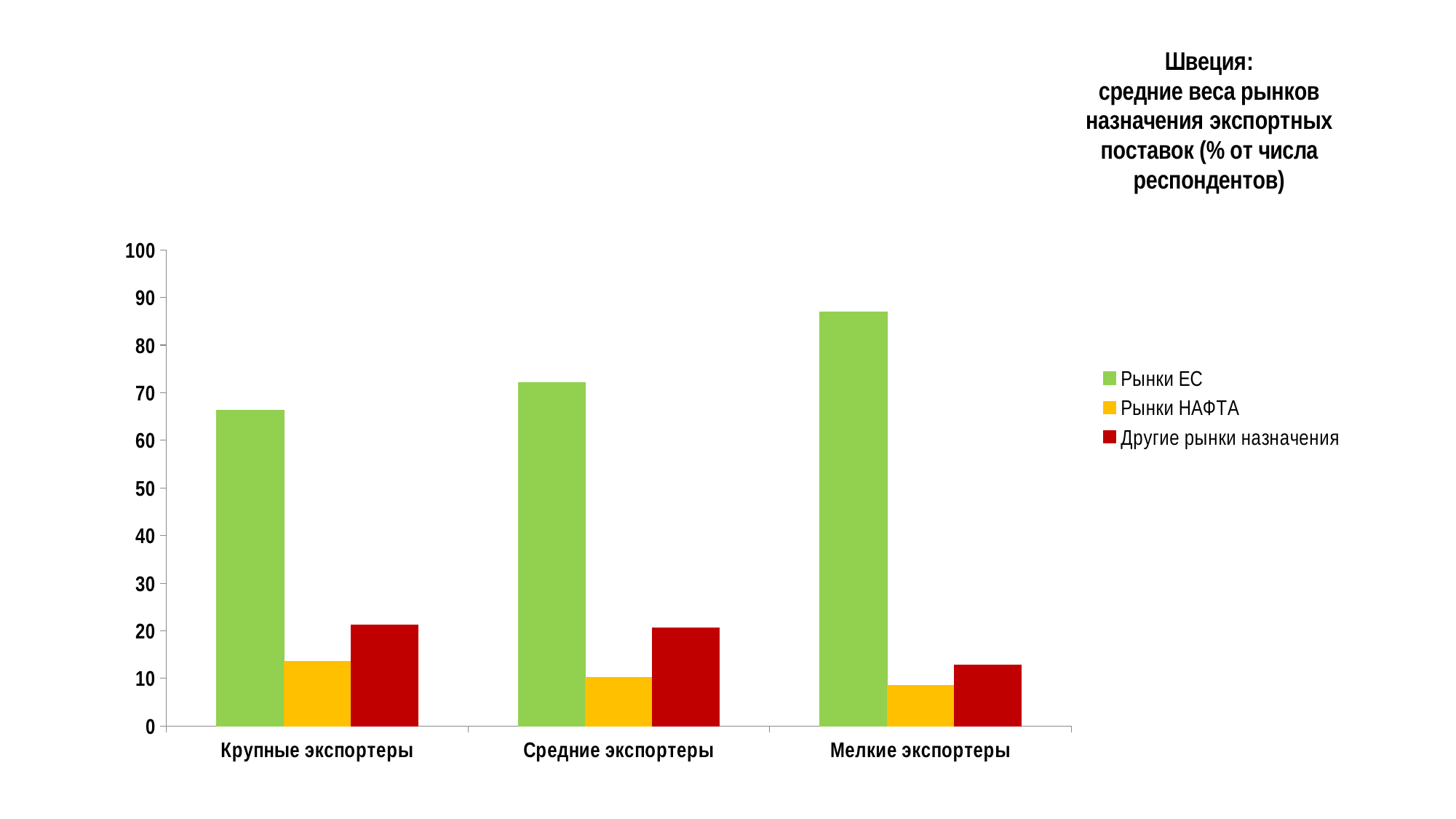
Which exporter category has the highest value for Рынки НАФТА? Крупные экспортеры Which exporter category has the highest value for Рынки ЕС? Мелкие экспортеры Is the value for Рынки ЕС for Мелкие экспортеры greater or less than 80? greater How many exporter categories are shown on the x axis? 3 Do the values for Рынки ЕС rise or fall from Крупные экспортеры to Мелкие экспортеры? rise Is the value for Рынки ЕС for Крупные экспортеры greater or less than 70? less What kind of chart is shown on the slide? bar chart Which exporter category has the lowest value for Рынки ЕС? Крупные экспортеры Which exporter category has the lowest value for Другие рынки назначения? Мелкие экспортеры Which is larger: Рынки НАФТА for Крупные экспортеры or Рынки НАФТА for Средние экспортеры? Крупные экспортеры How many series does the legend list? 3